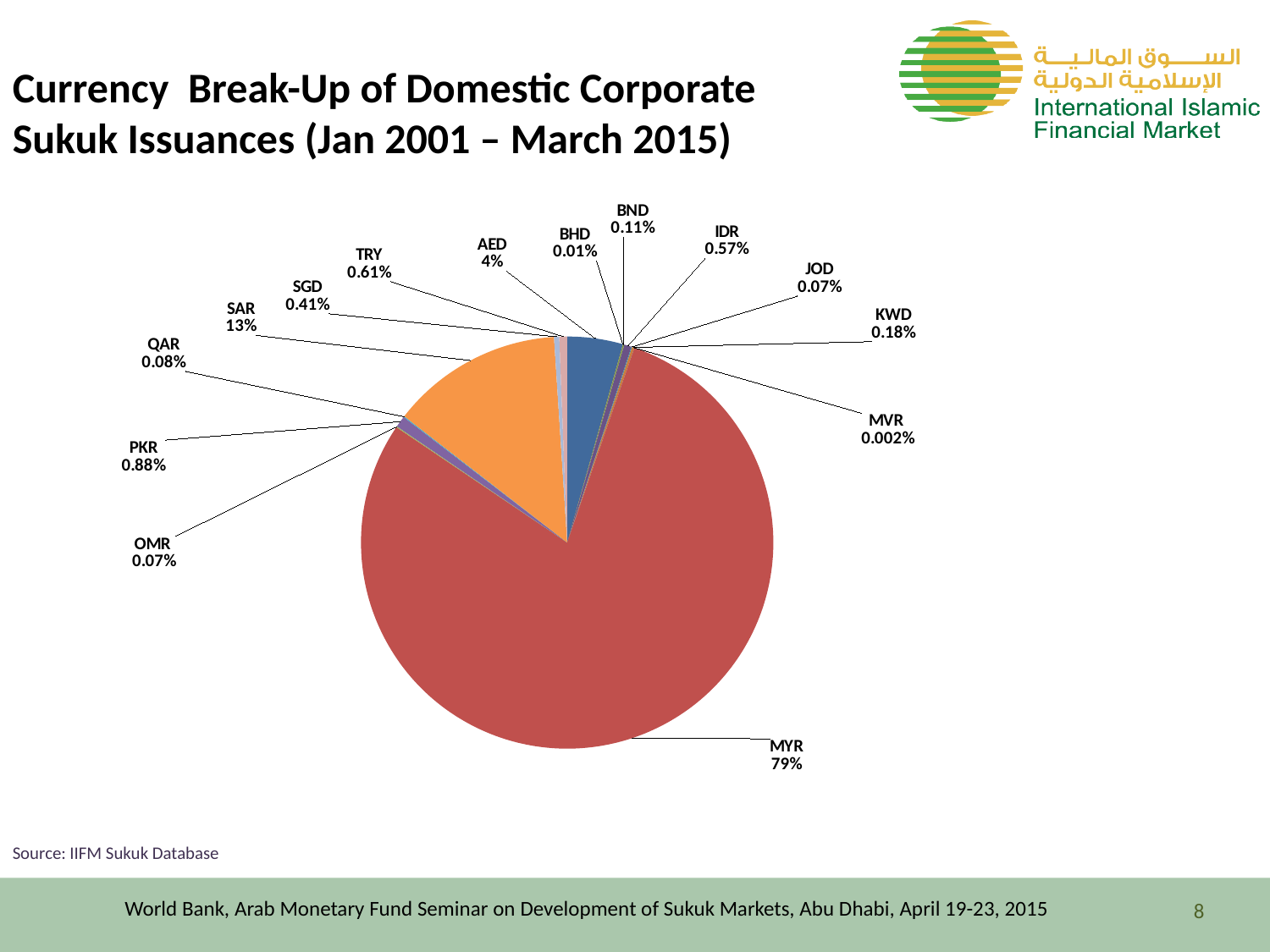
What is the value shown for AED? 4% What share of domestic corporate sukuk issuances is in MYR? 79% What type of chart is shown on the slide? Pie chart What is the value shown for MVR? 0.002% What percentage is shown for SAR? 13% Which currency has the largest share of the pie? MYR Which has a larger share, TRY or IDR? TRY What is the difference between the shares of MYR and SAR? 66% What percentage is shown for PKR? 0.88% Which currency has the smallest share of the pie? MVR What is the source cited for the chart? IIFM Sukuk Database How many currencies are shown in the pie chart? 14